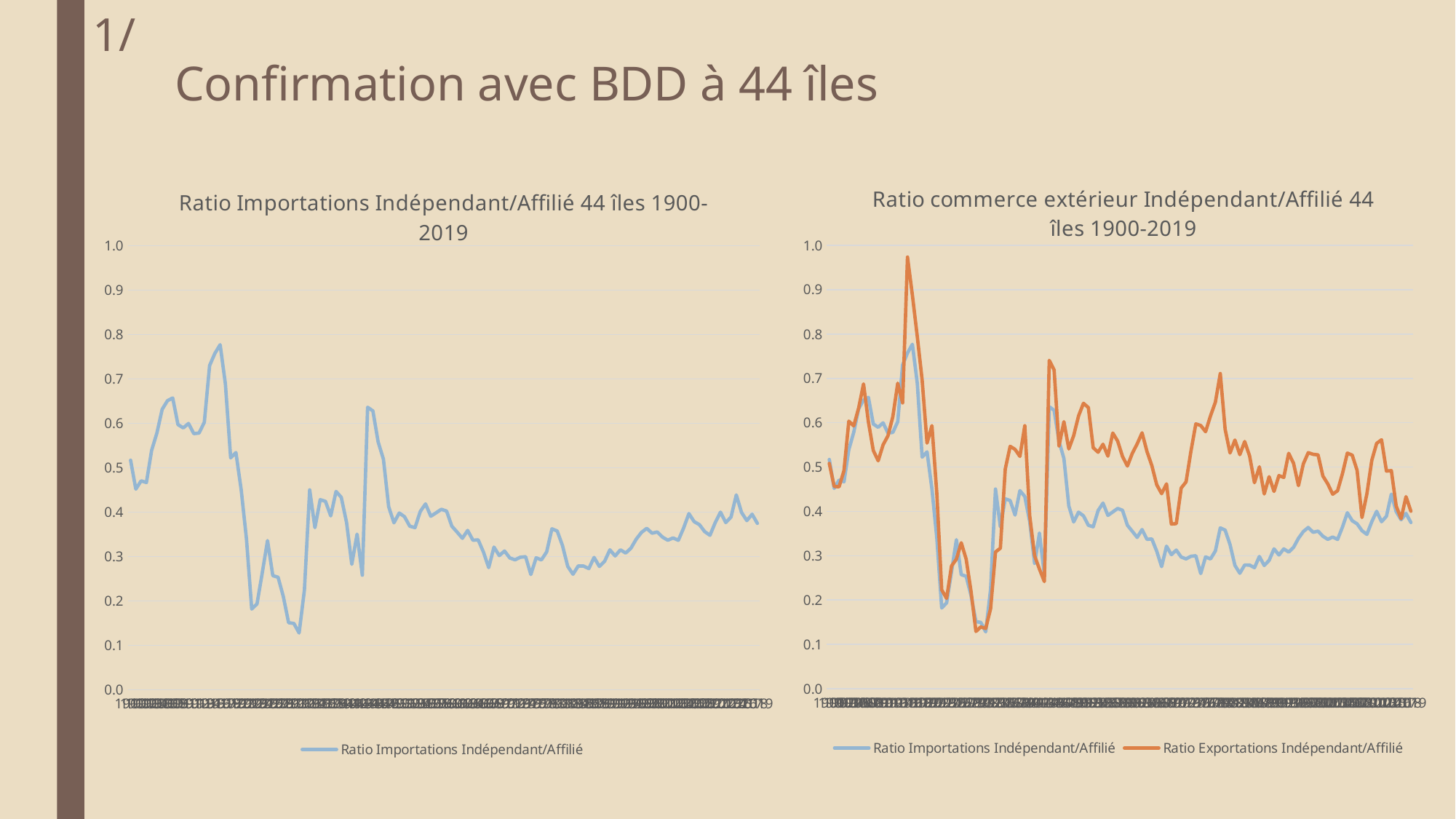
What is the maximum value shown on the y axis of the right chart? 1.0 How many series does the legend of the left chart list? 1 How many series does the legend of the right chart list? 2 In the left chart, is the Ratio Importations Indépendant/Affilié value at the end of the period (2019) higher or lower than at the start (1900)? lower In the right chart, which series reaches the higher peak value, Ratio Importations Indépendant/Affilié or Ratio Exportations Indépendant/Affilié? Ratio Exportations Indépendant/Affilié What kind of chart is the right chart, 'Ratio commerce extérieur Indépendant/Affilié 44 îles 1900-2019'? line chart What is the title of the left chart? Ratio Importations Indépendant/Affilié 44 îles 1900-2019 In the left chart, is the highest value reached by the Ratio Importations Indépendant/Affilié series greater or less than 0.7? greater In the right chart, is the highest value reached by the Ratio Exportations Indépendant/Affilié series greater or less than 0.9? greater What kind of chart is the left chart, 'Ratio Importations Indépendant/Affilié 44 îles 1900-2019'? line chart In the left chart, is the lowest value reached by the Ratio Importations Indépendant/Affilié series greater or less than 0.2? less In the right chart, which series is drawn in orange? Ratio Exportations Indépendant/Affilié